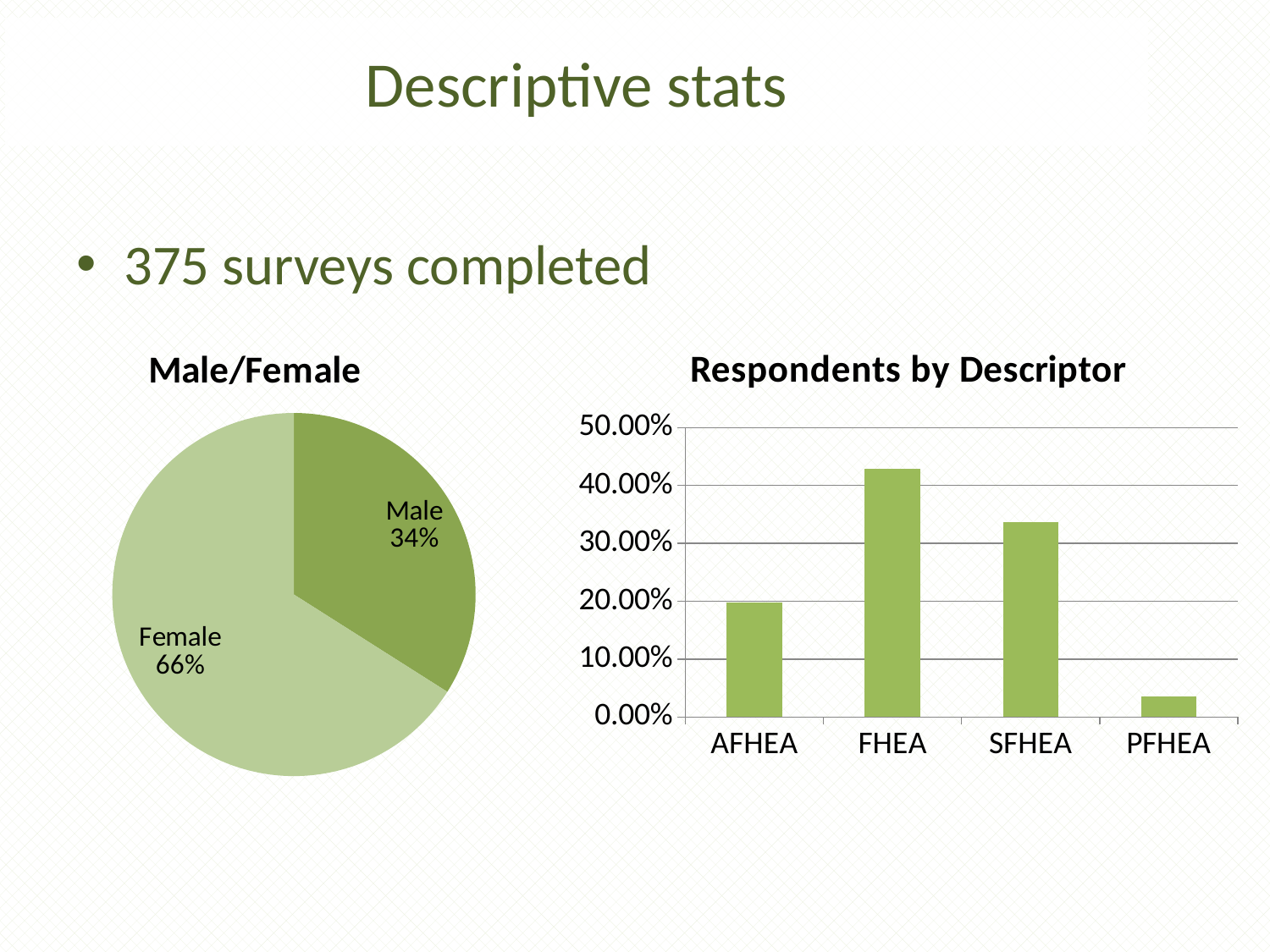
What kind of chart is the Male/Female chart? Pie chart How many slices does the Male/Female pie chart have? 2 In the Respondents by Descriptor chart, is the value for FHEA greater or less than 40.00%? greater In the Male/Female chart, which slice is larger, Male or Female? Female In the Male/Female chart, what share of respondents are Male? 34% In the Respondents by Descriptor chart, which descriptor has the highest value? FHEA How many categories are shown in the Respondents by Descriptor chart? 4 In the Male/Female chart, what share of respondents are Female? 66% In the Male/Female chart, what is the difference in percentage points between the Female and Male shares? 32 In the Respondents by Descriptor chart, which descriptor has the lowest value? PFHEA What kind of chart is the Respondents by Descriptor chart? Bar chart